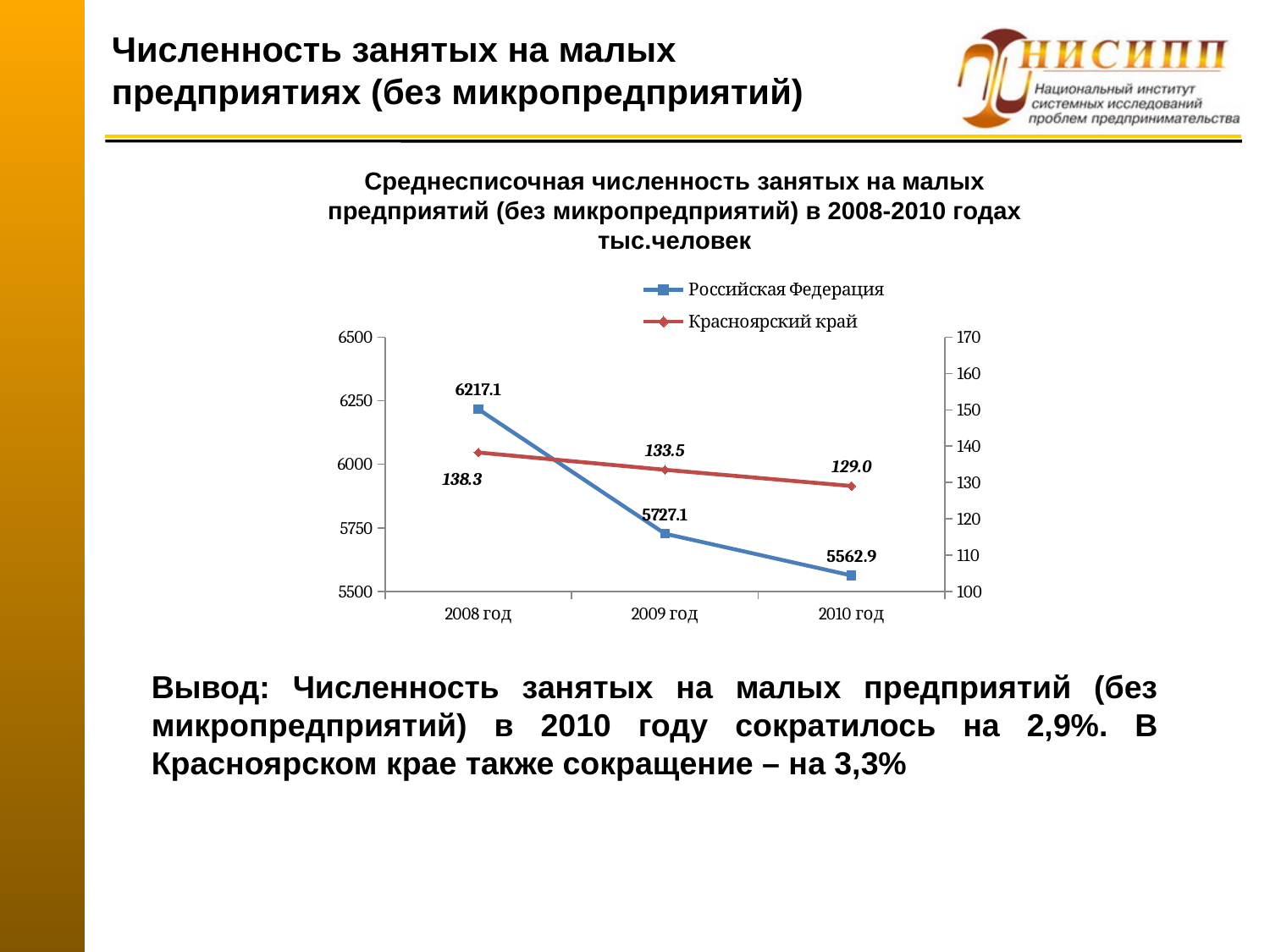
What is the difference between the Российская Федерация values for 2008 год and 2009 год? 490.0 What is the difference between the Красноярский край values for 2008 год and 2010 год? 9.3 What is the value for Красноярский край in 2010 год? 129.0 In which year is the value for Российская Федерация the highest? 2008 год What is the value for Российская Федерация in 2010 год? 5562.9 In which year is the value for Красноярский край the lowest? 2010 год What is the value for Красноярский край in 2009 год? 133.5 What type of chart is shown on the slide? line chart How many series does the legend list? 2 Do the values for Российская Федерация rise or fall from 2008 год to 2010 год? fall How many years are plotted on the x axis? 3 What is the value for Российская Федерация in 2008 год? 6217.1